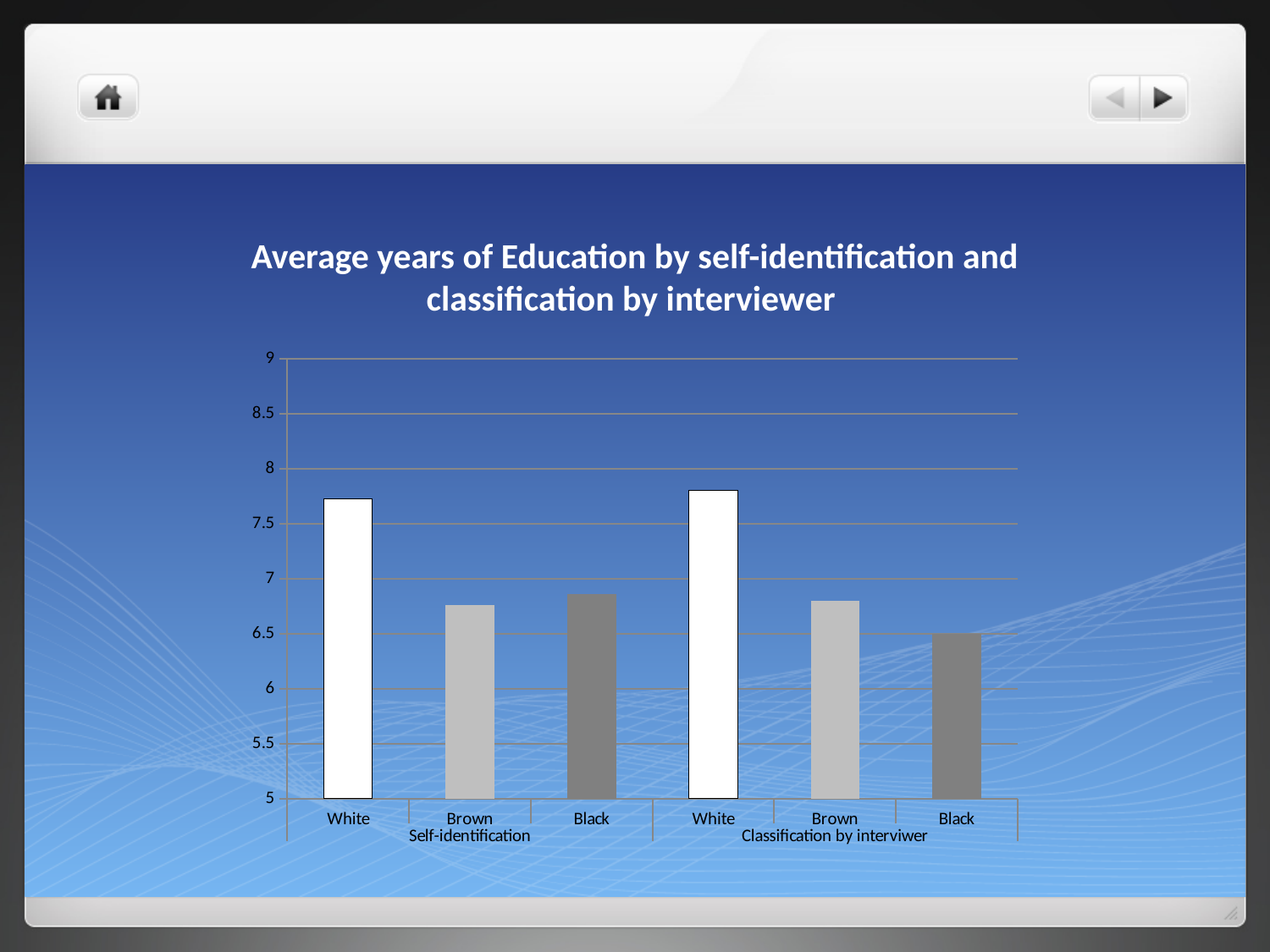
What is the title of the chart? Average years of Education by self-identification and classification by interviewer What kind of chart is shown on the slide? bar chart How many category groups are shown along the x axis? 2 Which bar has the lowest value in the chart? Black (Classification by interviewer) Is the value for Black under Self-identification greater or less than 7? less Is the value for Black under Classification by interviewer greater or less than 7? less How many bars are plotted in the chart? 6 Is the value for White under Self-identification greater or less than 7.5? greater Within the Self-identification group, which is larger: White or Brown? White Which is larger: Black under Self-identification or Black under Classification by interviewer? Black under Self-identification